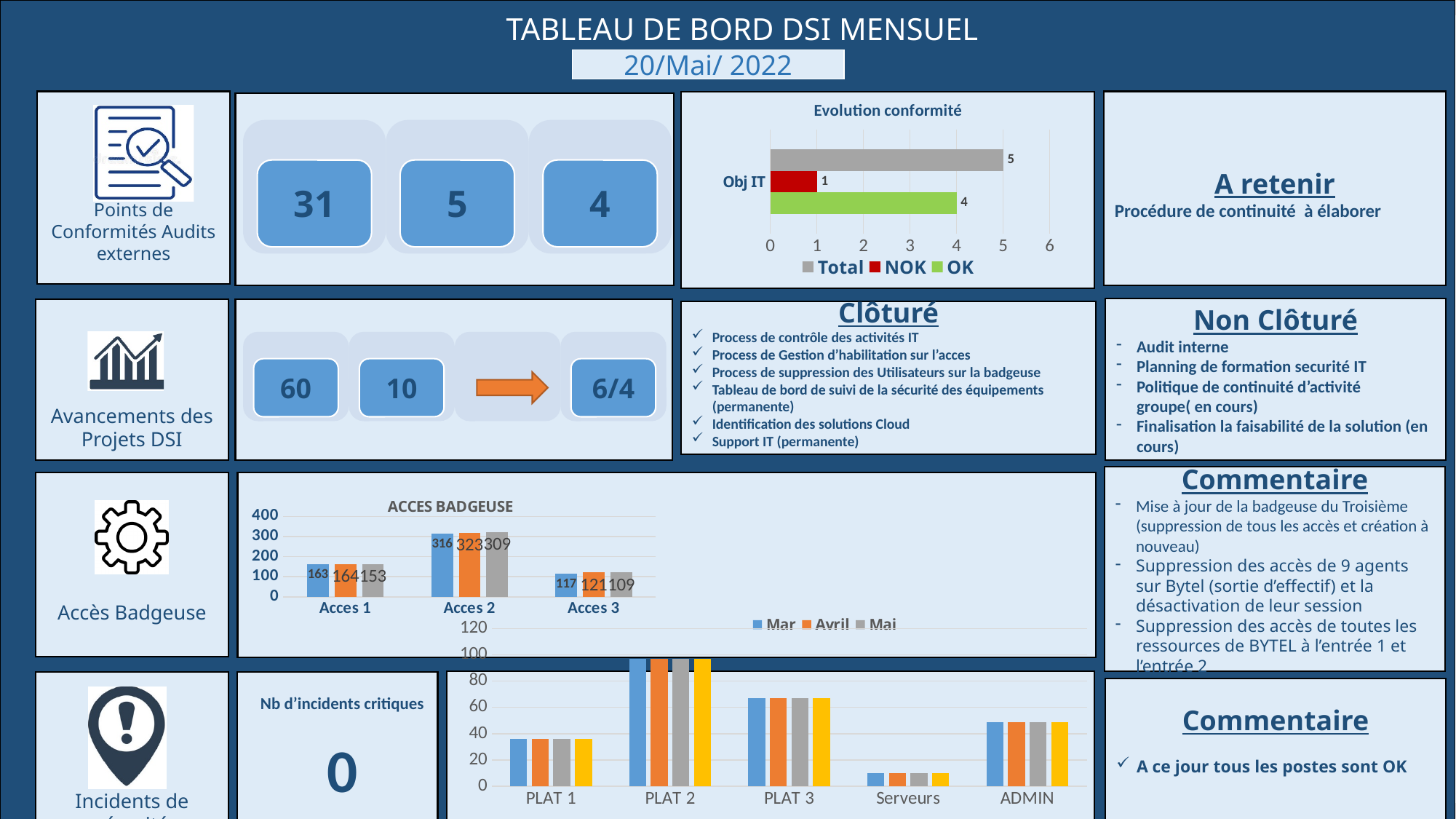
In the bottom chart with PLAT 1 to ADMIN, are the values for PLAT 2 greater or less than 80? greater In the 'ACCES BADGEUSE' chart, what is the Avril value for Acces 2? 323 What kind of chart is 'Evolution conformité'? bar chart In the 'Evolution conformité' chart, what is the difference between the OK and NOK values? 3 How many series does the legend of the 'Evolution conformité' chart list? 3 In the 'ACCES BADGEUSE' chart, what is the Mai value for Acces 3? 109 In the 'ACCES BADGEUSE' chart, what is the difference between the Mar and Mai values for Acces 1? 10 In the 'Evolution conformité' chart, what is the NOK value for Obj IT? 1 In the 'Evolution conformité' chart, what is the Total value for Obj IT? 5 In the 'ACCES BADGEUSE' chart, which category has the highest Mar value? Acces 2 In the bottom chart with PLAT 1 to ADMIN, which category has the lowest values? Serveurs In the 'ACCES BADGEUSE' chart, how many categories are shown on the x axis? 3